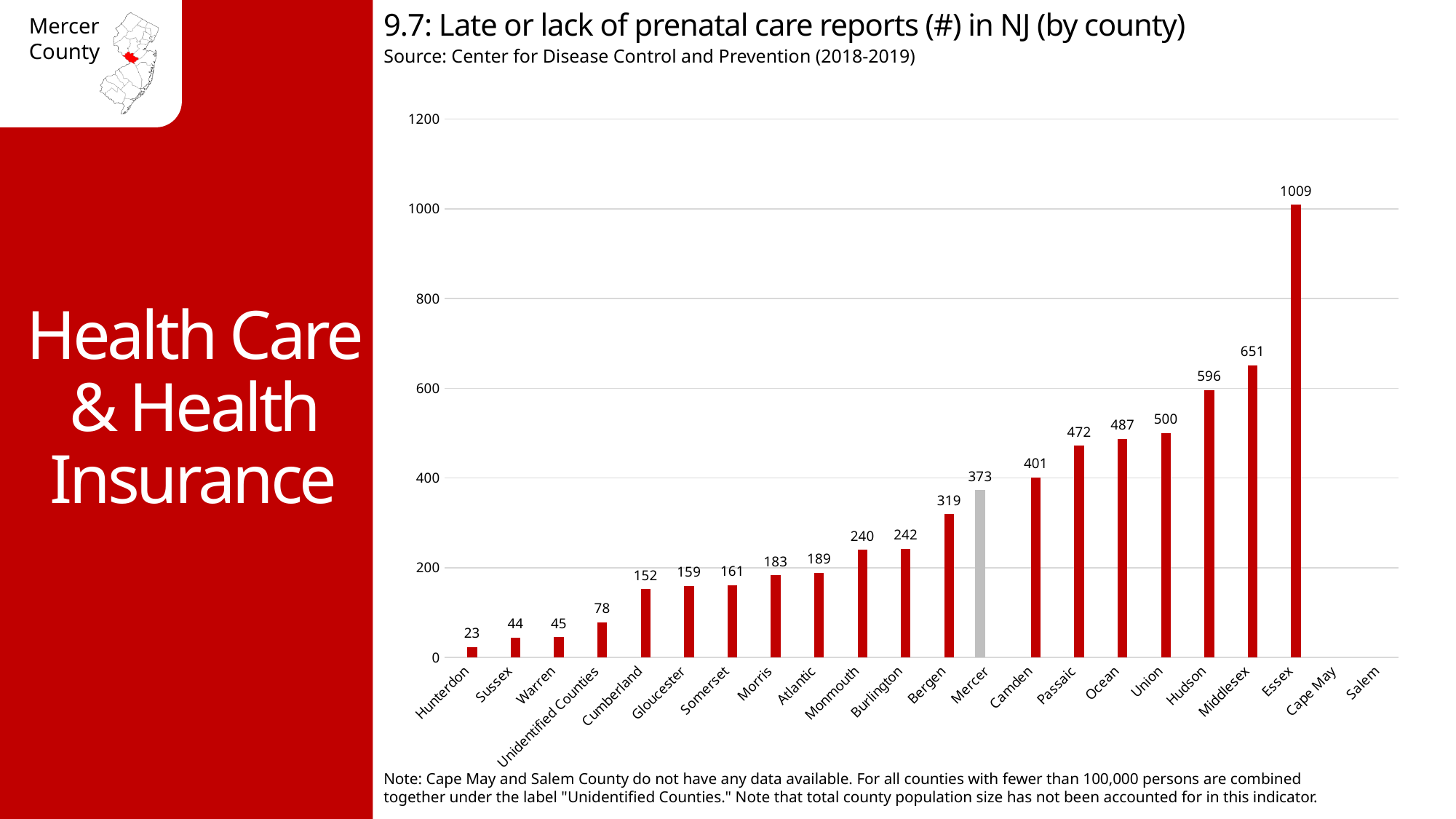
How many county labels are shown on the x axis? 22 What is the difference between the values for Essex and Middlesex? 358 What type of chart is shown on the slide? Bar chart What is the value shown for Unidentified Counties? 78 Which county with a plotted bar has the lowest number of reports? Hunterdon What is the number of late or lack of prenatal care reports for Mercer County? 373 Which has a higher value, Hudson or Union? Hudson What is the difference between the values for Mercer and Bergen? 54 Is the value for Camden greater or less than 400? greater Which two counties on the x axis have no bar because no data is available? Cape May and Salem Which county has the highest number of late or lack of prenatal care reports? Essex What is the value shown for Essex County? 1009